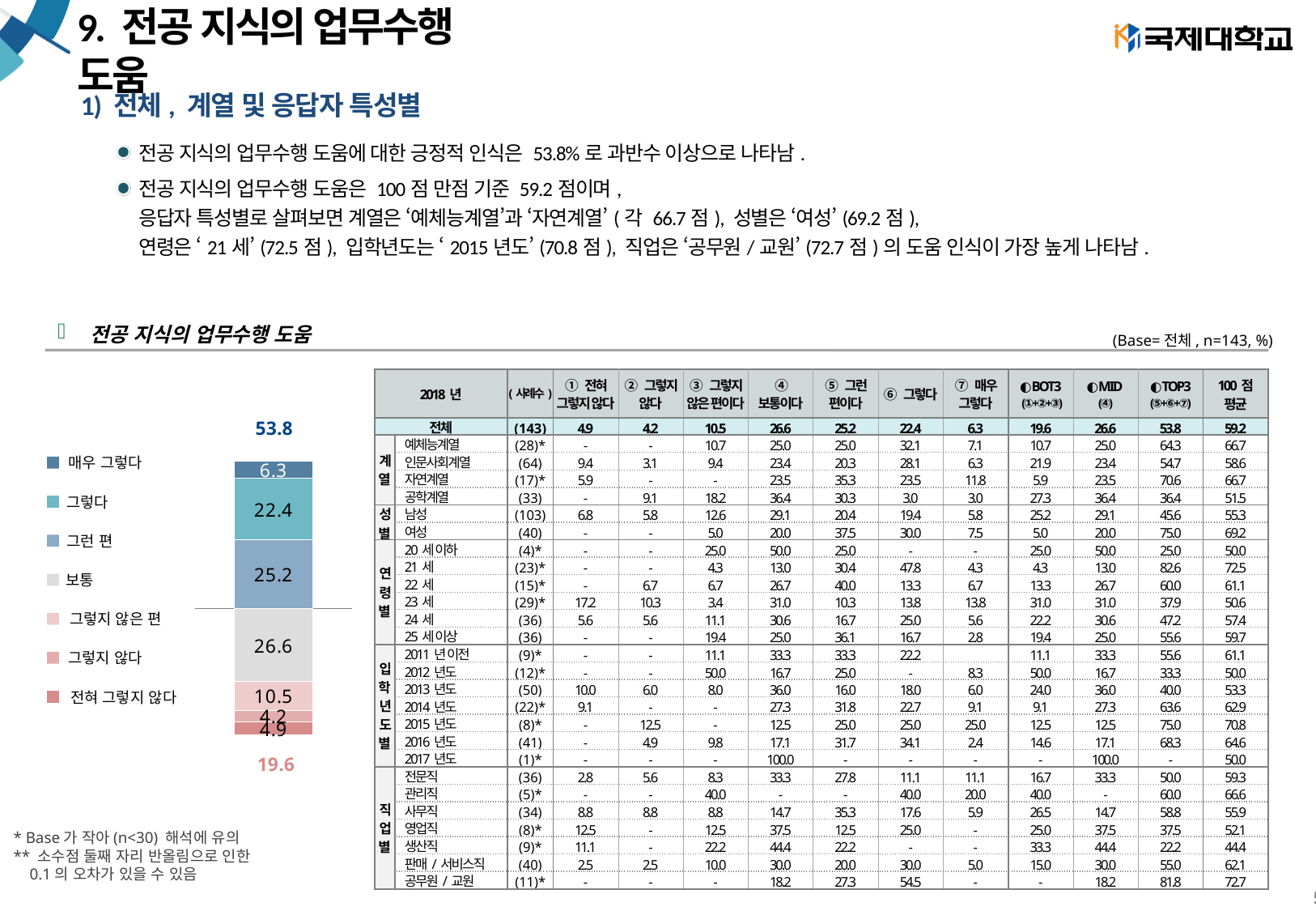
In the stacked bar chart, what is the value for '보통'? 26.6 How many entries does the legend of the stacked bar chart list? 7 What kind of chart is shown on the left of the slide? bar chart Which segment of the stacked bar has the largest value? 보통 In the stacked bar chart, what is the value for '전혀 그렇지 않다'? 4.9 How many segments make up the stacked bar? 7 Which segment of the stacked bar has the smallest value? 그렇지 않다 What value is printed above the stacked bar (the positive total)? 53.8 Which is larger in the stacked bar chart, '그렇지 않은 편' or '그렇지 않다'? 그렇지 않은 편 What is the difference between the values for '그런 편' and '그렇다' in the stacked bar chart? 2.8 In the stacked bar chart, what is the value for '그렇다'? 22.4 In the stacked bar chart, what is the value for '매우 그렇다'? 6.3